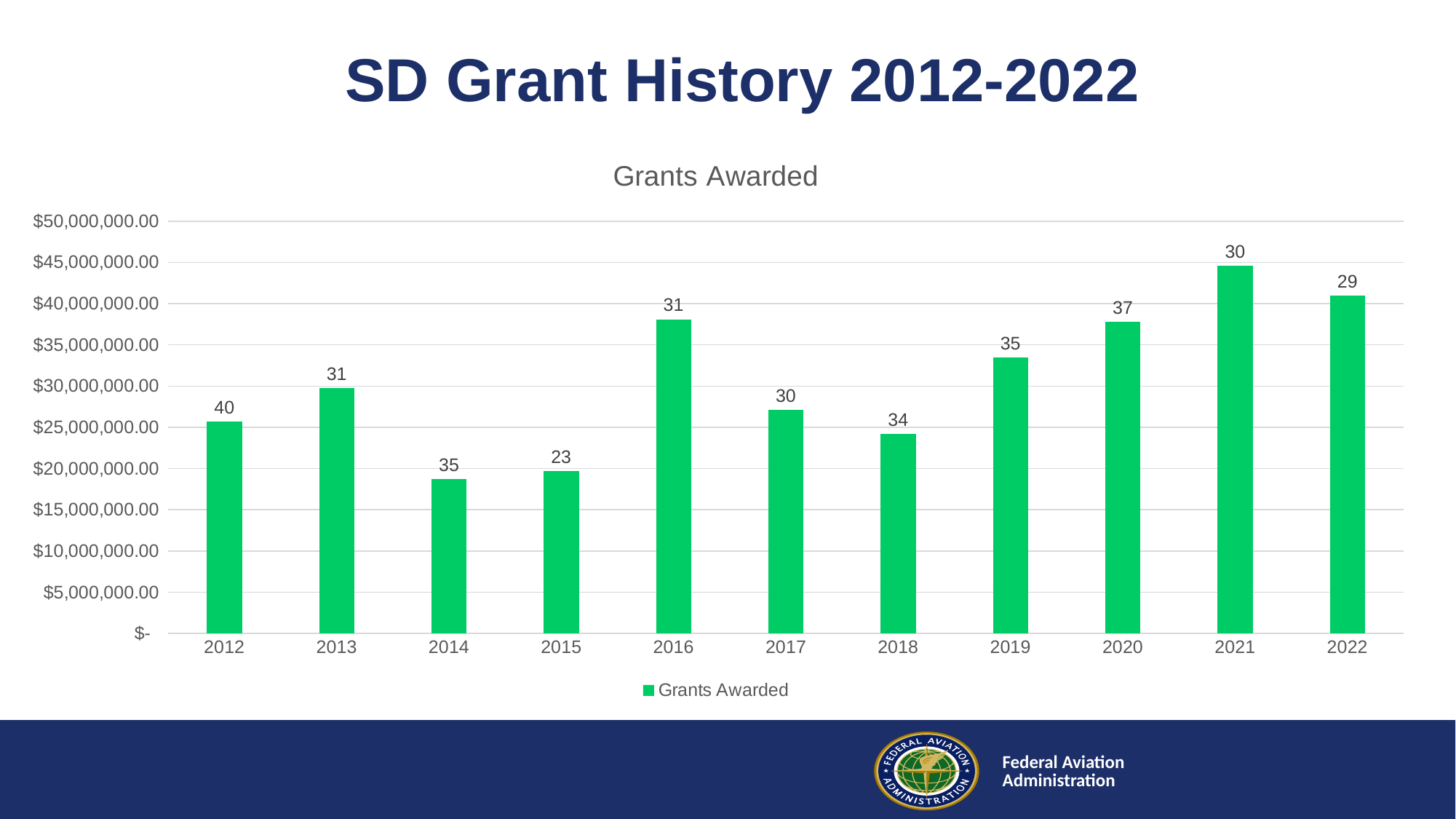
Is the bar for 2014 greater or less than $20,000,000.00? less What number is printed above the bar for 2012? 40 Which bar is taller, 2012 or 2013? 2013 Is the bar for 2021 greater or less than $40,000,000.00? greater How many years are shown on the x axis of the chart? 11 What is the title of the chart? Grants Awarded What type of chart is shown on the slide? bar chart Which year has the largest number printed above its bar? 2012 What number is printed above the bar for 2020? 37 Which year has the tallest bar in the chart? 2021 What number is printed above the bar for 2015? 23 How many series does the legend list? 1